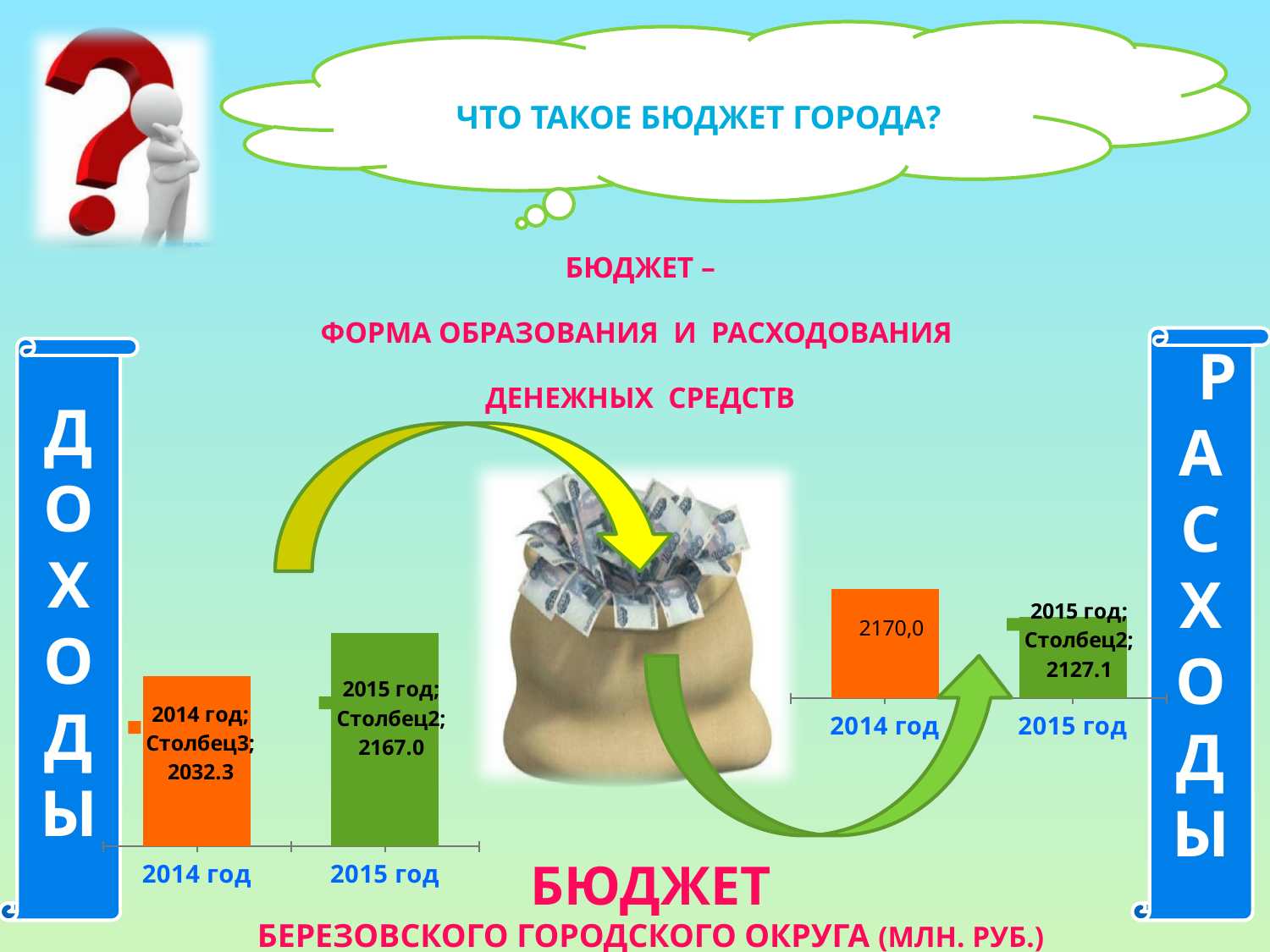
On the left chart (ДОХОДЫ), which year has the higher value? 2015 год Do the values on the left chart (ДОХОДЫ) rise or fall from 2014 год to 2015 год? rise What kind of chart is the left chart (ДОХОДЫ)? bar chart On the right chart (РАСХОДЫ), what is the value for 2014 год? 2170,0 On the right chart (РАСХОДЫ), is the value for 2014 год larger or smaller than the value for 2015 год? larger On the right chart (РАСХОДЫ), what is the value for 2015 год? 2127.1 On the right chart (РАСХОДЫ), what is the difference between the 2014 год and 2015 год values? 42.9 On the right chart (РАСХОДЫ), which year has the lower value? 2015 год On the left chart (ДОХОДЫ), what is the value for 2015 год? 2167.0 On the left chart (ДОХОДЫ), what is the difference between the 2015 год and 2014 год values? 134.7 On the left chart (ДОХОДЫ), what is the value for 2014 год? 2032.3 Do the values on the right chart (РАСХОДЫ) rise or fall from 2014 год to 2015 год? fall